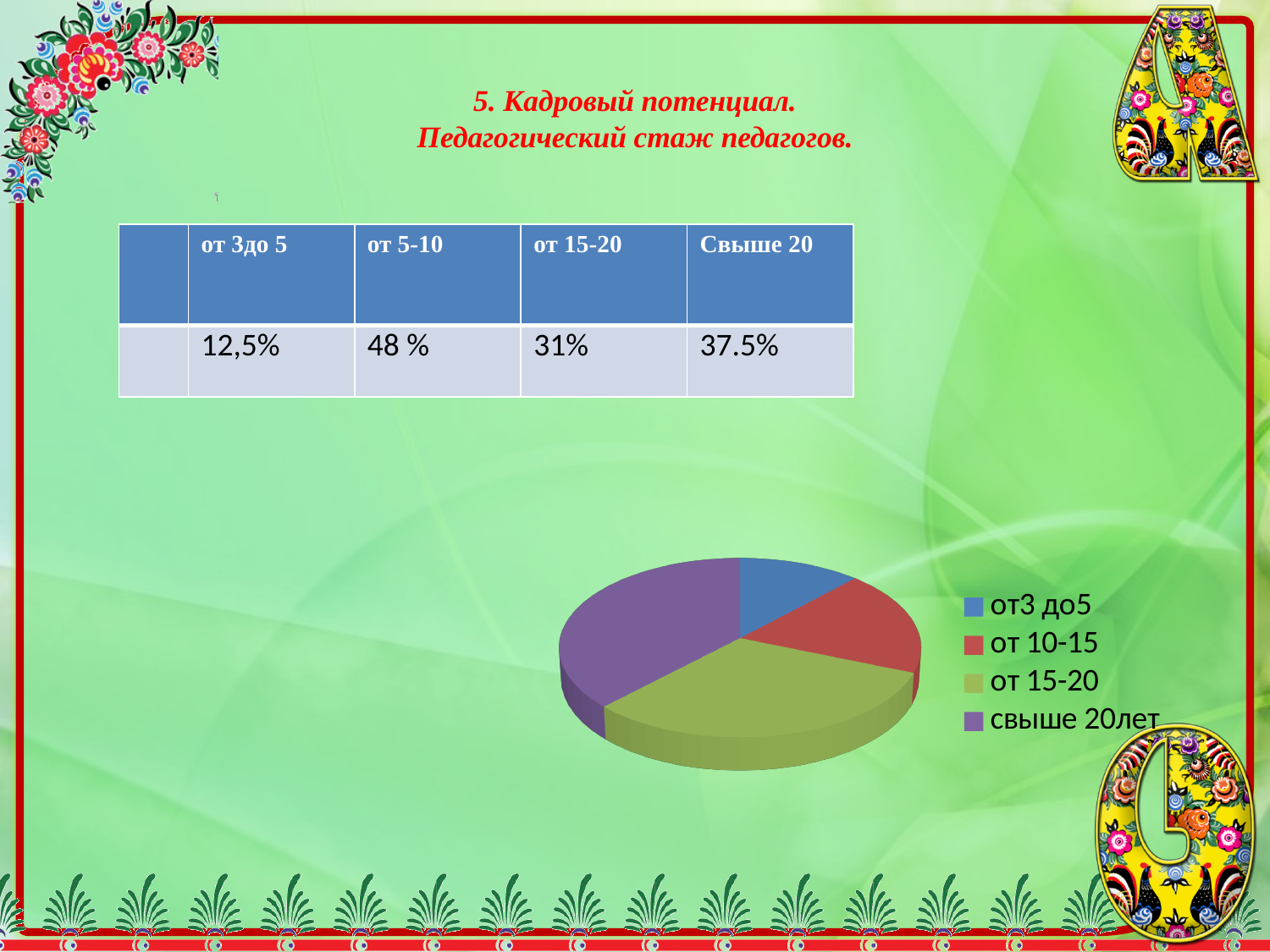
Which category has the smallest slice in the pie chart? от3 до5 What kind of chart is shown on the slide? pie chart How many entries does the legend of the pie chart list? 4 How many slices does the pie chart have? 4 What colour is the slice for свыше 20лет in the pie chart? purple Which legend entry is shown in blue in the pie chart? от3 до5 Which slice is larger in the pie chart, от3 до5 or свыше 20лет? свыше 20лет Which slice is larger in the pie chart, от 10-15 or от 15-20? от 15-20 Which slice is larger in the pie chart, от3 до5 or от 10-15? от 10-15